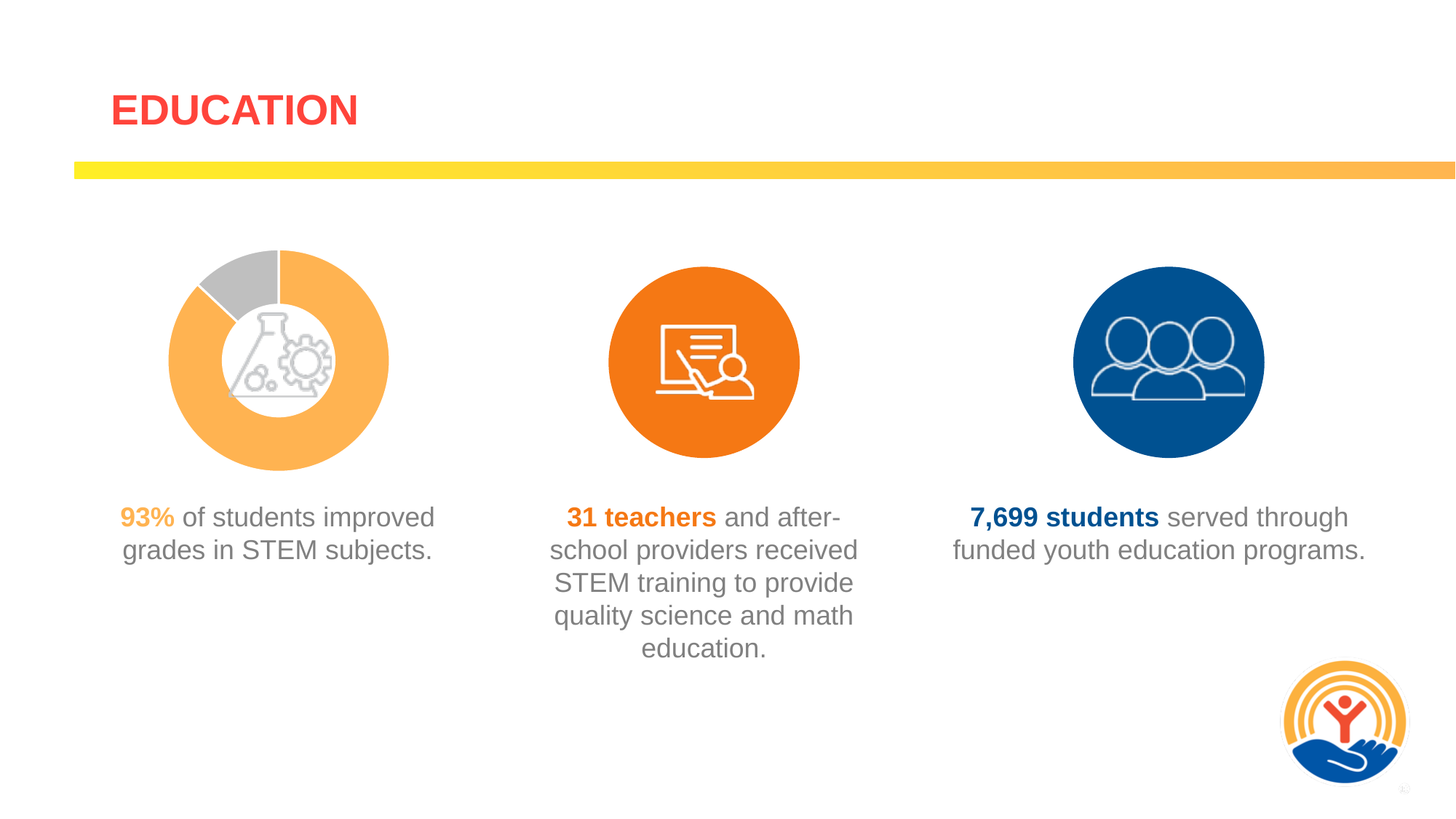
In the donut chart on the left, which segment is larger, the orange one or the gray one? Orange What kind of chart is shown on the left of the slide? Donut (pie) chart In the donut chart on the left, is the gray segment's share greater or less than 50%? less What icon appears in the centre of the donut chart on the left? A flask with a gear How many segments does the donut chart on the left have? 2 In the donut chart on the left, is the orange segment's share greater or less than 50%? greater